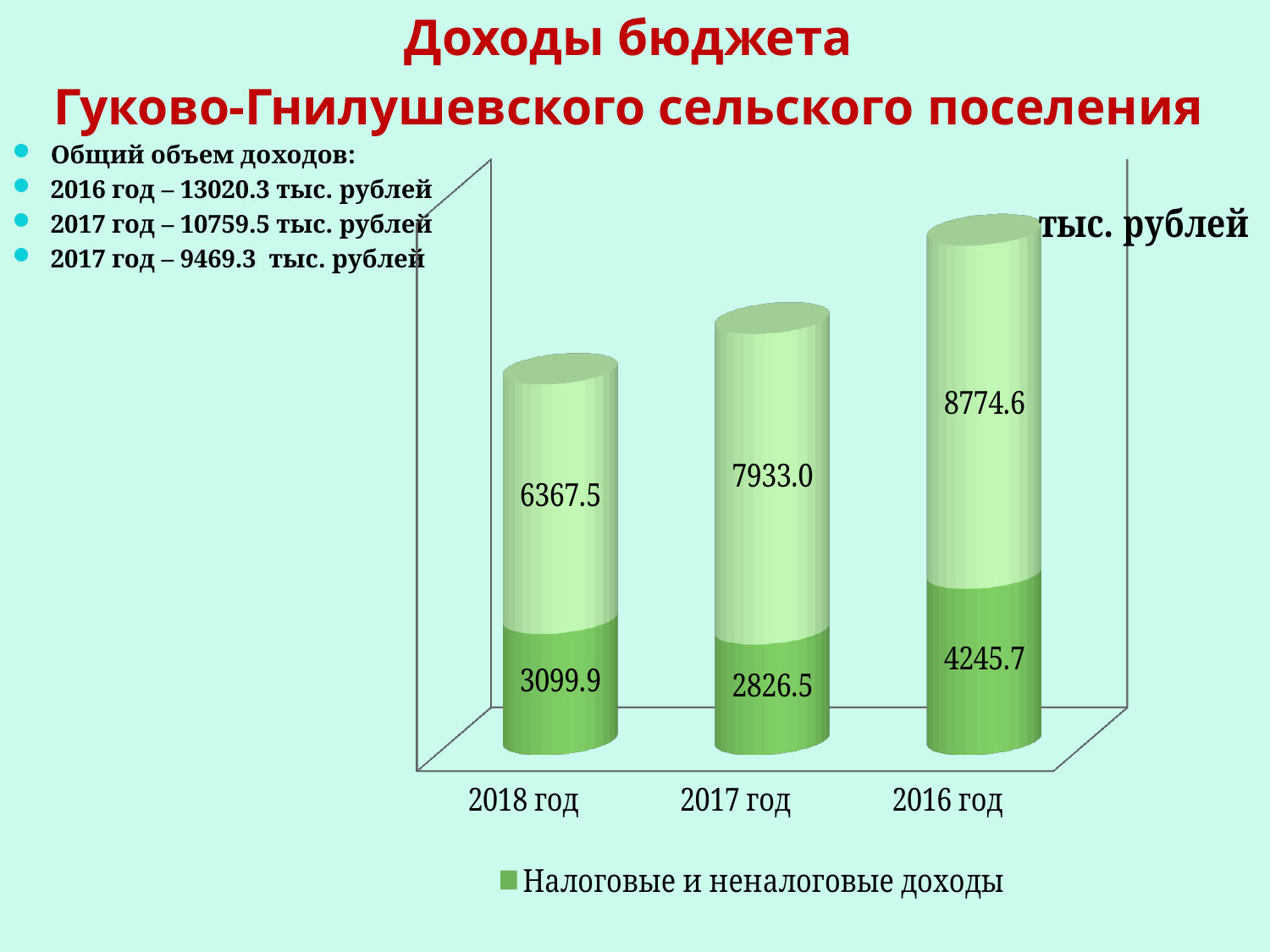
What is the difference between the 'Налоговые и неналоговые доходы' values for 2016 год and 2017 год? 1419.2 Which is larger: the upper light green segment for 2018 год or for 2017 год? 2017 год What is the value of the upper light green segment for 2017 год? 7933.0 What is the value of the dark green 'Налоговые и неналоговые доходы' segment for 2016 год? 4245.7 What is the total of the stacked bar for 2017 год? 10759.5 What is the total of the stacked bar for 2016 год? 13020.3 What is the value of the dark green 'Налоговые и неналоговые доходы' segment for 2018 год? 3099.9 Which year has the lowest value for 'Налоговые и неналоговые доходы'? 2017 год Which year has the highest value for 'Налоговые и неналоговые доходы'? 2016 год What is the value of the upper light green segment for 2016 год? 8774.6 What type of chart is shown on the slide? Stacked bar chart How many years are shown on the x axis of the chart? 3